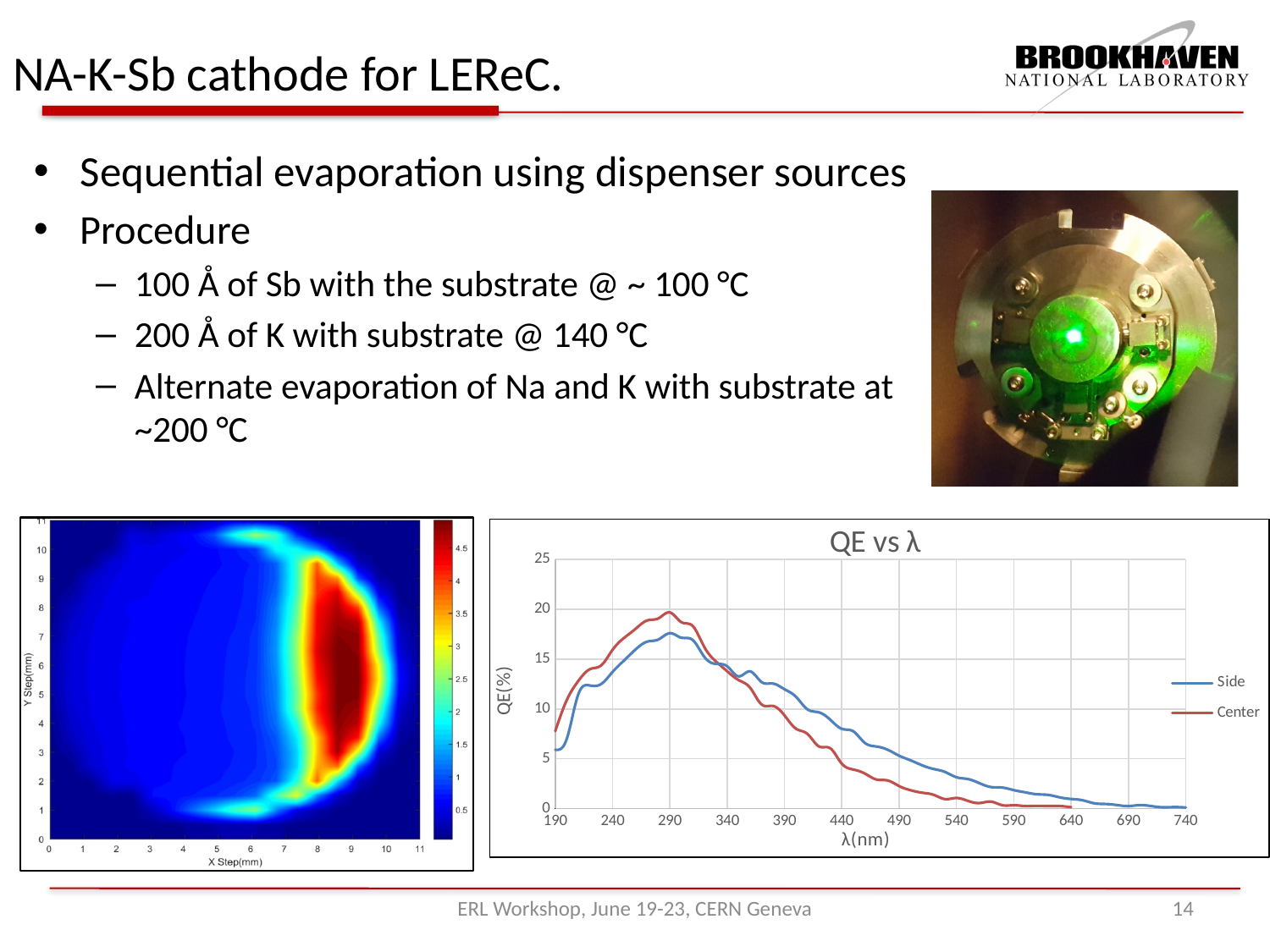
In the 'QE vs λ' chart, is the Center value at 190 nm greater or less than 10? less In the 'QE vs λ' chart, what are the two legend entries? Side and Center In the 'QE vs λ' chart, is the Side value at 390 nm greater or less than 10? greater In the 'QE vs λ' chart, which series has the higher value at 490 nm, Side or Center? Side In the 'QE vs λ' chart, which series reaches the highest peak QE? Center In the 'QE vs λ' chart, how many series does the legend list? 2 In the 'QE vs λ' chart, is the Center value at 290 nm greater or less than 15? greater In the 'QE vs λ' chart, does the Side series rise or fall as λ increases from 290 nm to 740 nm? fall In the 'QE vs λ' chart, which series has the higher value at 290 nm, Side or Center? Center What kind of chart is the 'QE vs λ' chart? line chart What is the title of the line chart on the slide? QE vs λ